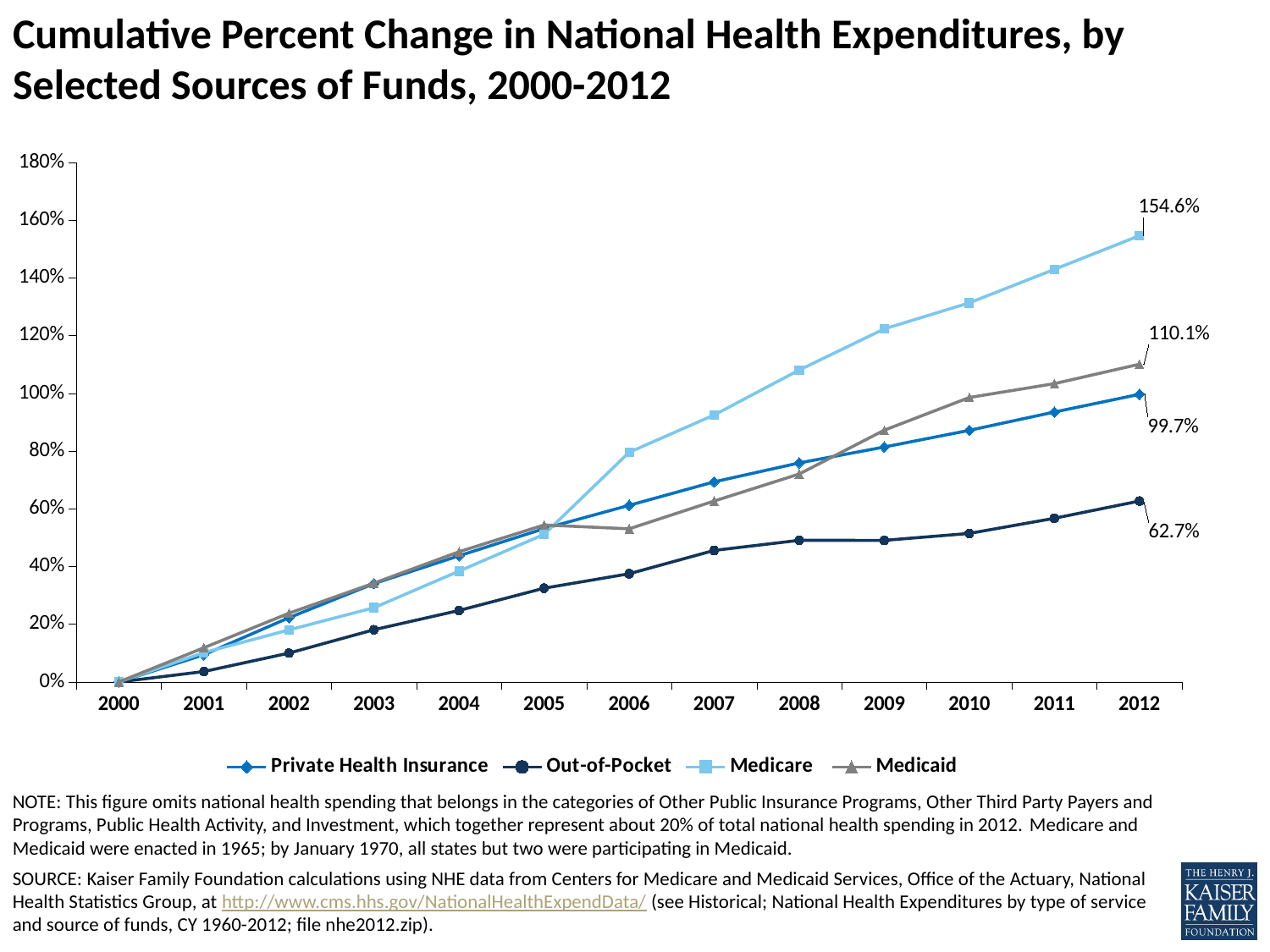
Which source of funds has the lowest cumulative percent change in 2012? Out-of-Pocket What kind of chart is shown on the slide? Line chart What is the cumulative percent change for Medicare in 2012? 154.6% What is the cumulative percent change for Private Health Insurance in 2012? 99.7% What is the cumulative percent change for Medicaid in 2012? 110.1% How many series does the legend list? 4 What is the cumulative percent change for Out-of-Pocket in 2012? 62.7% Does the Medicare line rise or fall from 2000 to 2012? Rises What is the difference between the 2012 values for Medicare and Out-of-Pocket? 91.9 percentage points In 2012, which is larger: the value for Medicaid or the value for Private Health Insurance? Medicaid Which source of funds has the highest cumulative percent change in 2012? Medicare Is the value for Medicare in 2008 greater or less than 100%? greater